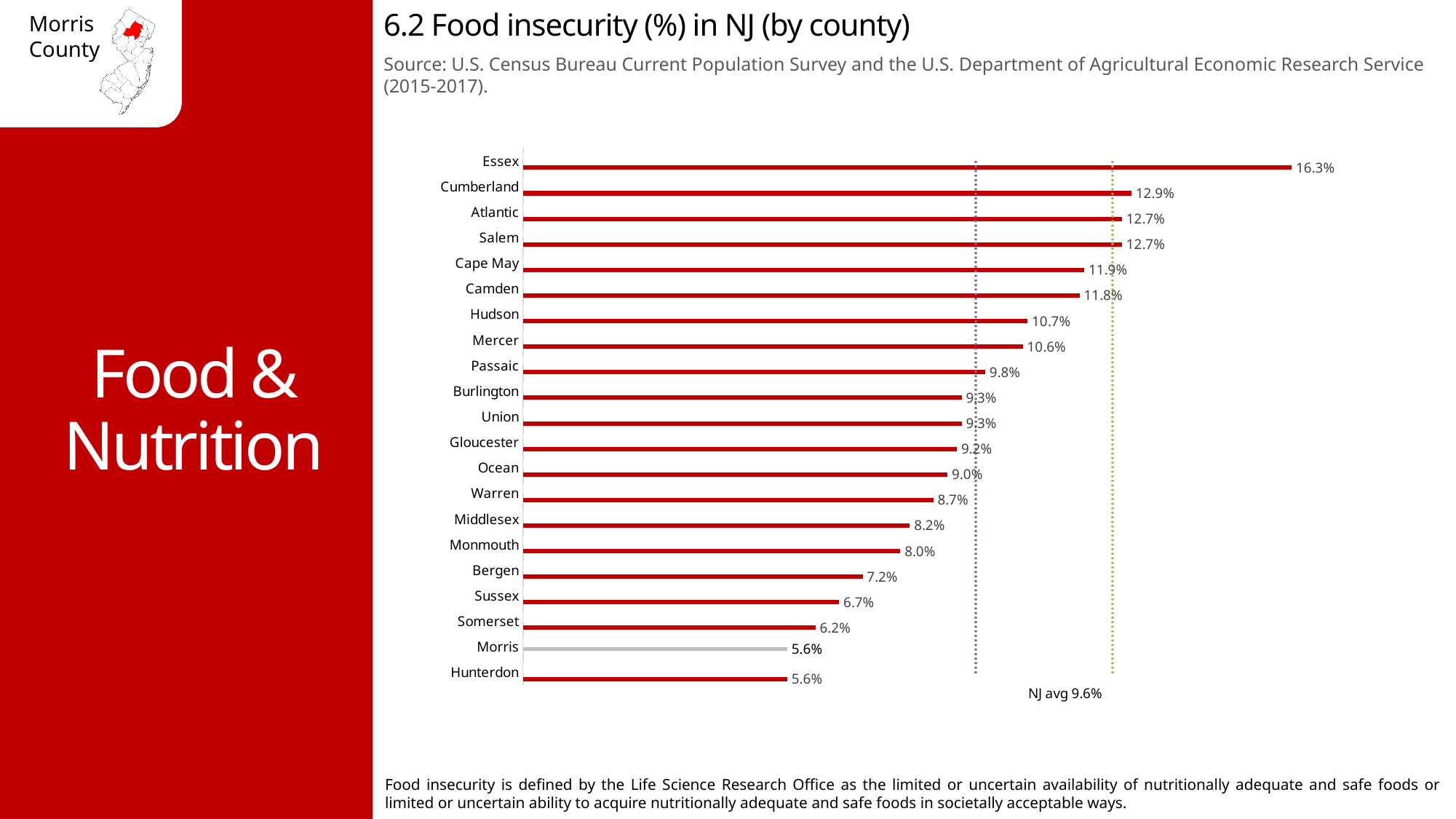
What is the food insecurity rate for Bergen County? 7.2% What is the difference between the NJ average food insecurity rate and Morris County's rate? 4.0 percentage points What is the difference in food insecurity rate between Essex and Cumberland counties? 3.4 percentage points What is the NJ average food insecurity rate marked on the chart? 9.6% Which county has the highest food insecurity rate? Essex What kind of chart is used to show food insecurity by county? Bar chart What is the food insecurity rate for Morris County? 5.6% What is the food insecurity rate for Essex County? 16.3% What is the lowest food insecurity rate shown on the chart? 5.6% Which county has a higher food insecurity rate, Camden or Passaic? Camden Do the food insecurity values rise or fall going from the top county to the bottom county? Fall How many counties are shown on the chart? 21